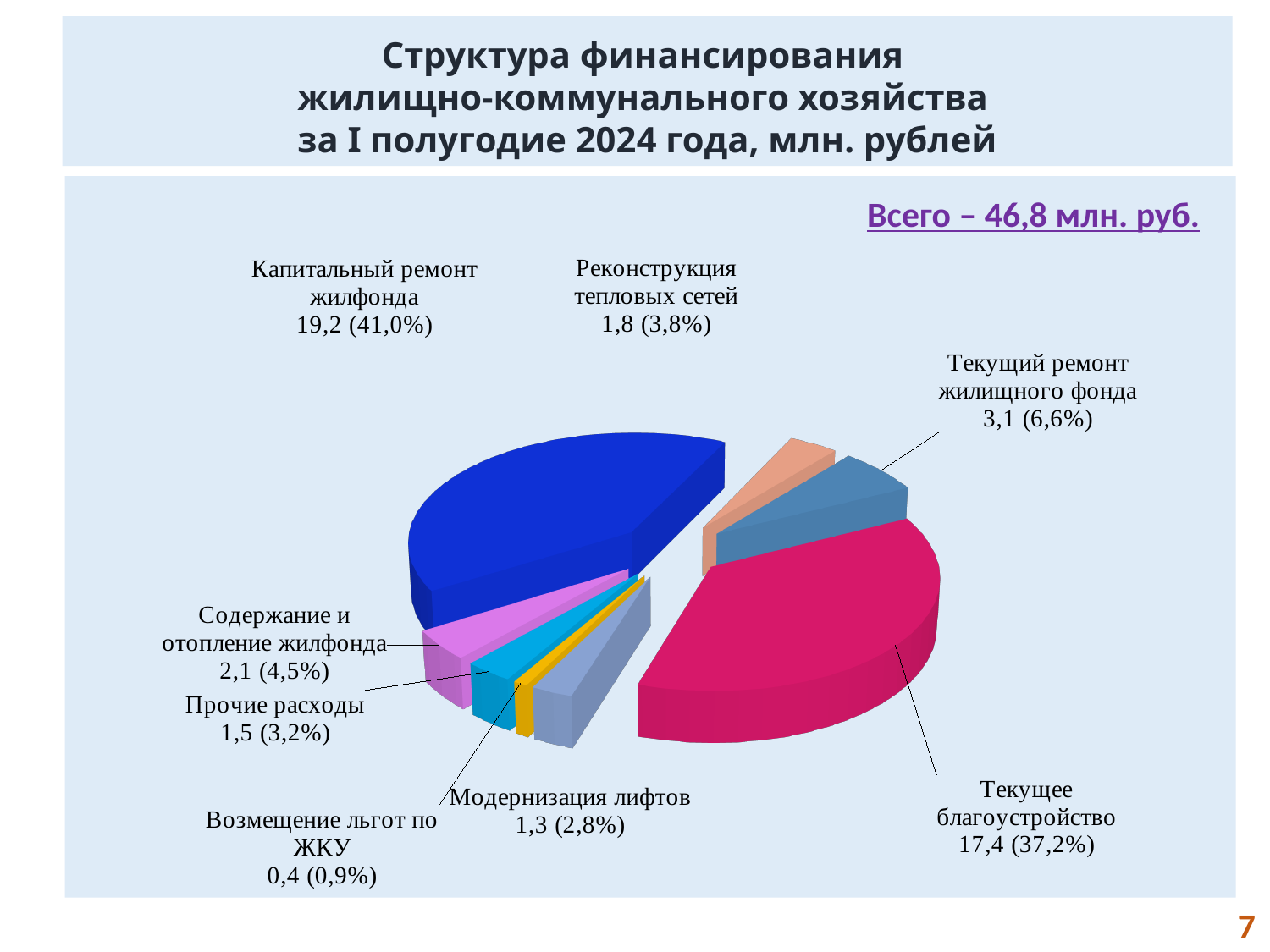
What kind of chart is shown on the slide? Pie chart How many categories (slices) does the pie chart have? 8 What share of the pie does «Текущий ремонт жилищного фонда» take? 6,6% What is the value for «Текущее благоустройство»? 17,4 (37,2%) Which is larger: «Содержание и отопление жилфонда» or «Прочие расходы»? Содержание и отопление жилфонда What is the value for «Возмещение льгот по ЖКУ»? 0,4 (0,9%) What is the difference between «Капитальный ремонт жилфонда» and «Текущее благоустройство» in млн. рублей? 1,8 Which category has the largest share of the pie? Капитальный ремонт жилфонда Which category has the smallest share of the pie? Возмещение льгот по ЖКУ What is the value for «Реконструкция тепловых сетей»? 1,8 (3,8%) What total amount is stated on the slide for the whole pie? 46,8 млн. руб. What is the value for «Капитальный ремонт жилфонда»? 19,2 (41,0%)